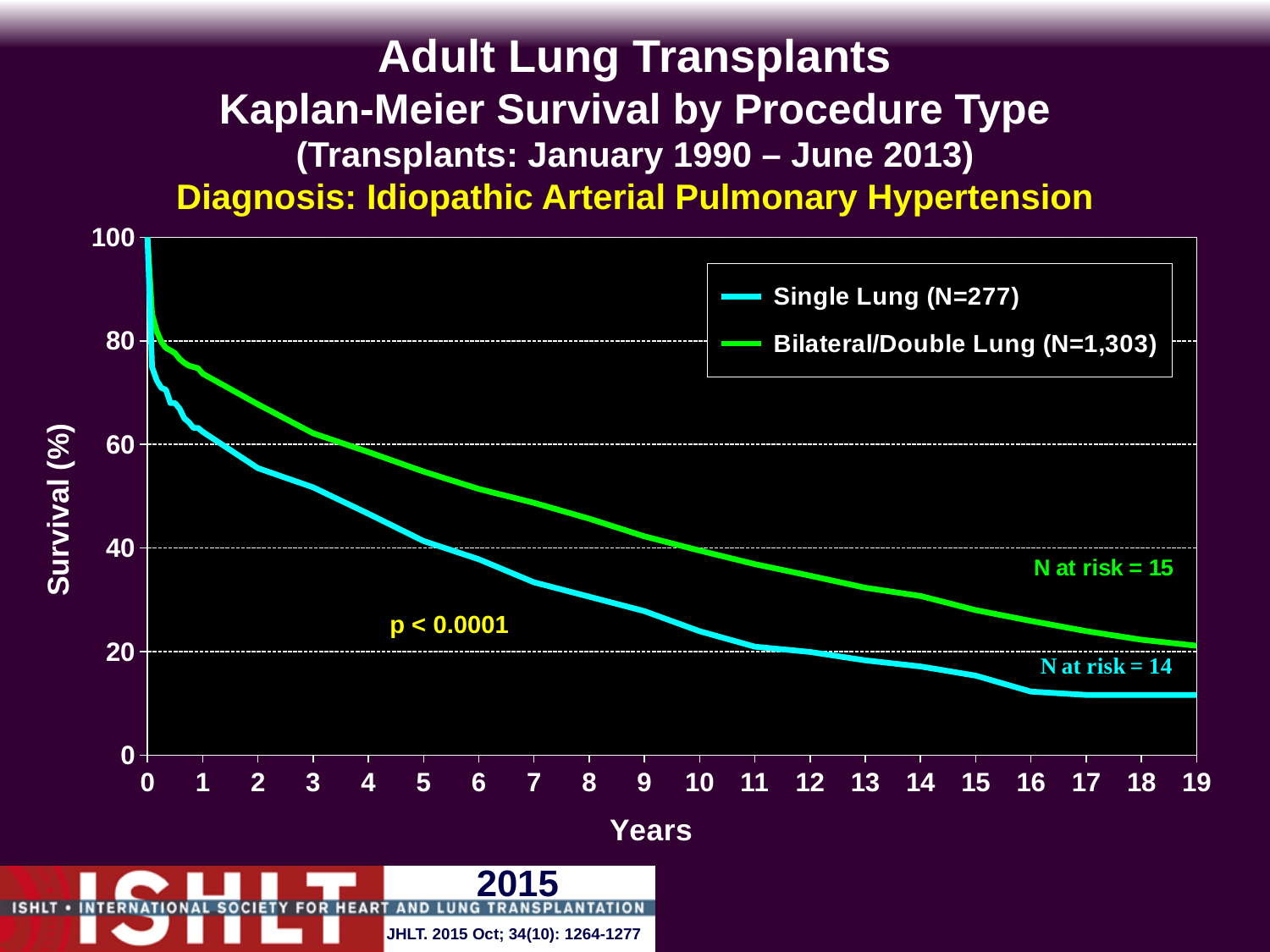
Do the survival curves rise or fall as years increase? fall At 10 years, which series has the higher survival, Single Lung or Bilateral/Double Lung? Bilateral/Double Lung Is the survival for Single Lung at 2 years greater or less than 60? less What kind of chart is shown on the slide? line chart What is the N at risk shown for the Single Lung curve at the end of follow-up? 14 What is the N at risk shown for the Bilateral/Double Lung curve at the end of follow-up? 15 Is the survival for Bilateral/Double Lung at 2 years greater or less than 60? greater What is the N for the Bilateral/Double Lung series in the legend? 1,303 What is the N for the Single Lung series in the legend? 277 How many series does the legend list? 2 Is the survival for Single Lung at 19 years greater or less than 20? less What p-value is printed on the chart? p < 0.0001